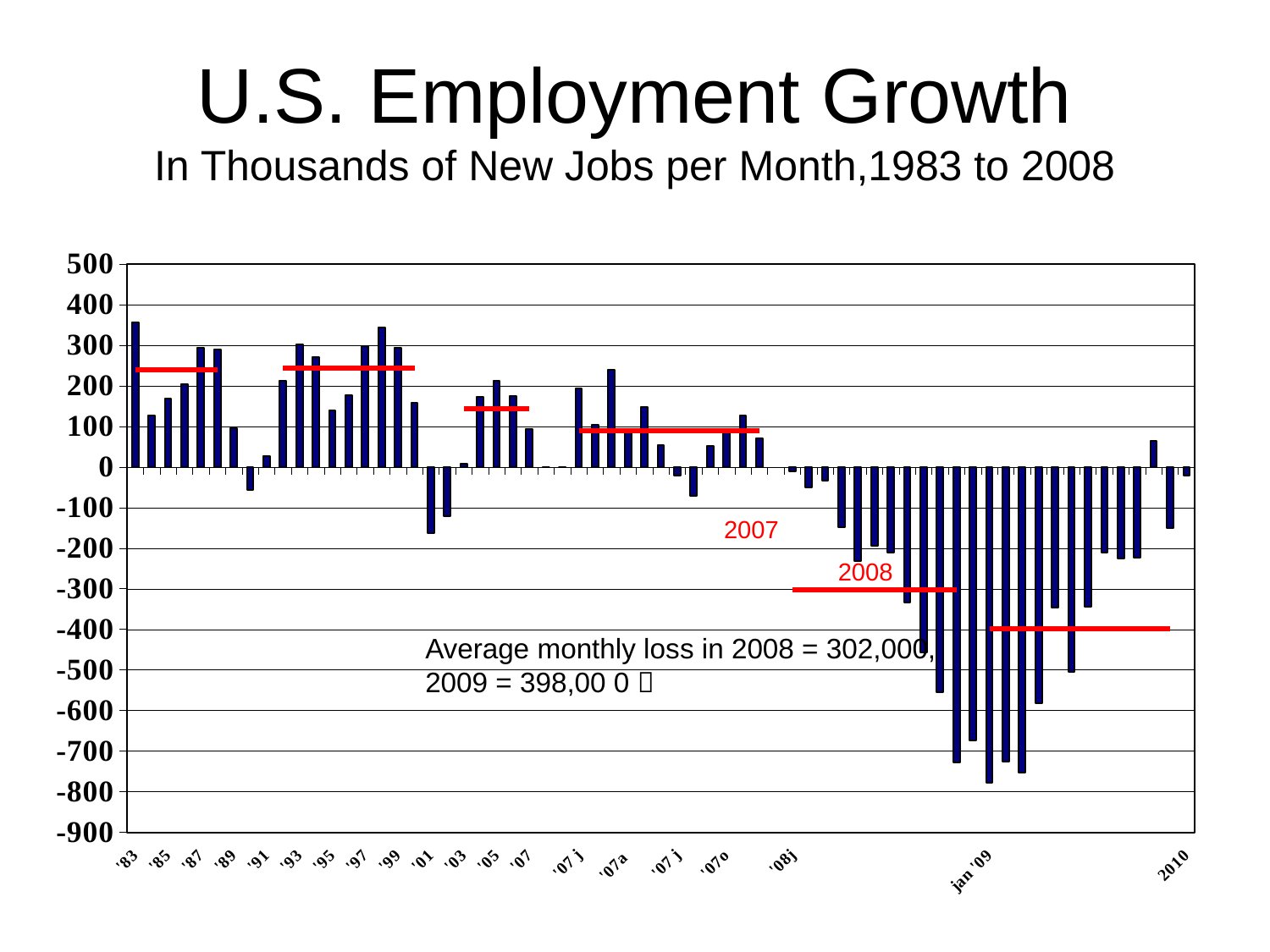
Is the value for '01 greater or less than -100? less Is the value for '85 greater or less than 100? greater Which category has the lowest value on the chart? jan '09 Do the values generally rise or fall from '08j to jan '09? fall Is the value for '91 greater or less than 100? less Which is larger, the value for '83 or the value for '91? '83 What is the title of the chart? U.S. Employment Growth According to the text on the chart, what was the average monthly loss in 2008? 302,000 Which is larger, the value for '85 or the value for '01? '85 What kind of chart is shown on the slide? bar chart